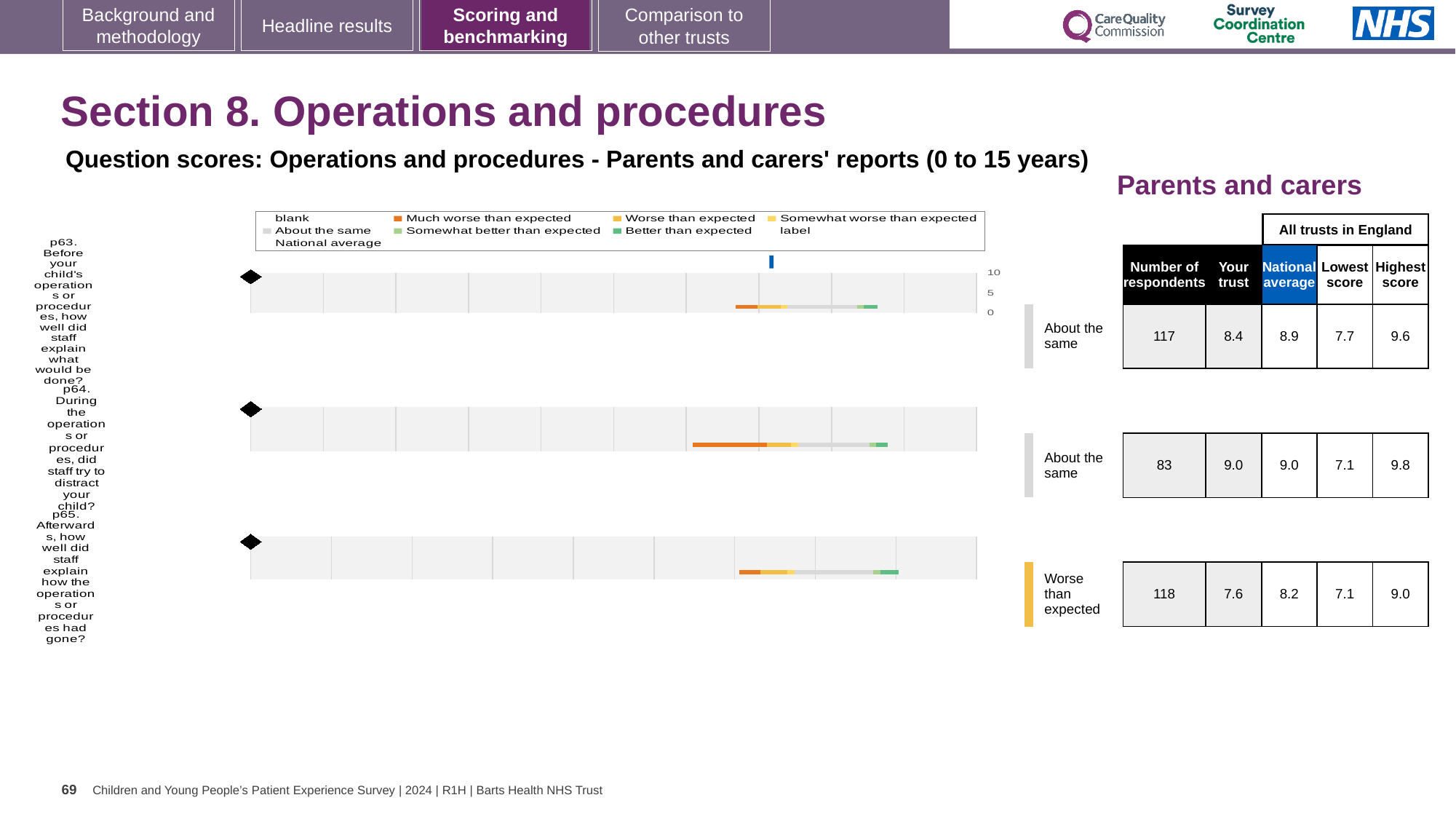
What is the difference between the highest score and the lowest score for p63? 1.9 Is the 'Your trust' score for p63 higher or lower than the national average? lower What kind of chart is used to show the question scores? bar chart Which of the three questions has the highest 'Your trust' score? p64 What is the 'Your trust' score for p63 (Before your child's operations or procedures, how well did staff explain what would be done?)? 8.4 What is the difference between the national average and the 'Your trust' score for p65? 0.6 What is the national average score for p64 (During the operations or procedures, did staff try to distract your child?)? 9.0 How many questions (p63, p64, p65) are plotted on the slide? 3 What is the 'Your trust' score for p65 (Afterwards, how well did staff explain how the operations or procedures had gone?)? 7.6 How many respondents answered p64? 83 What benchmark category is shown for p65? Worse than expected Which of the three questions has the lowest 'Your trust' score? p65